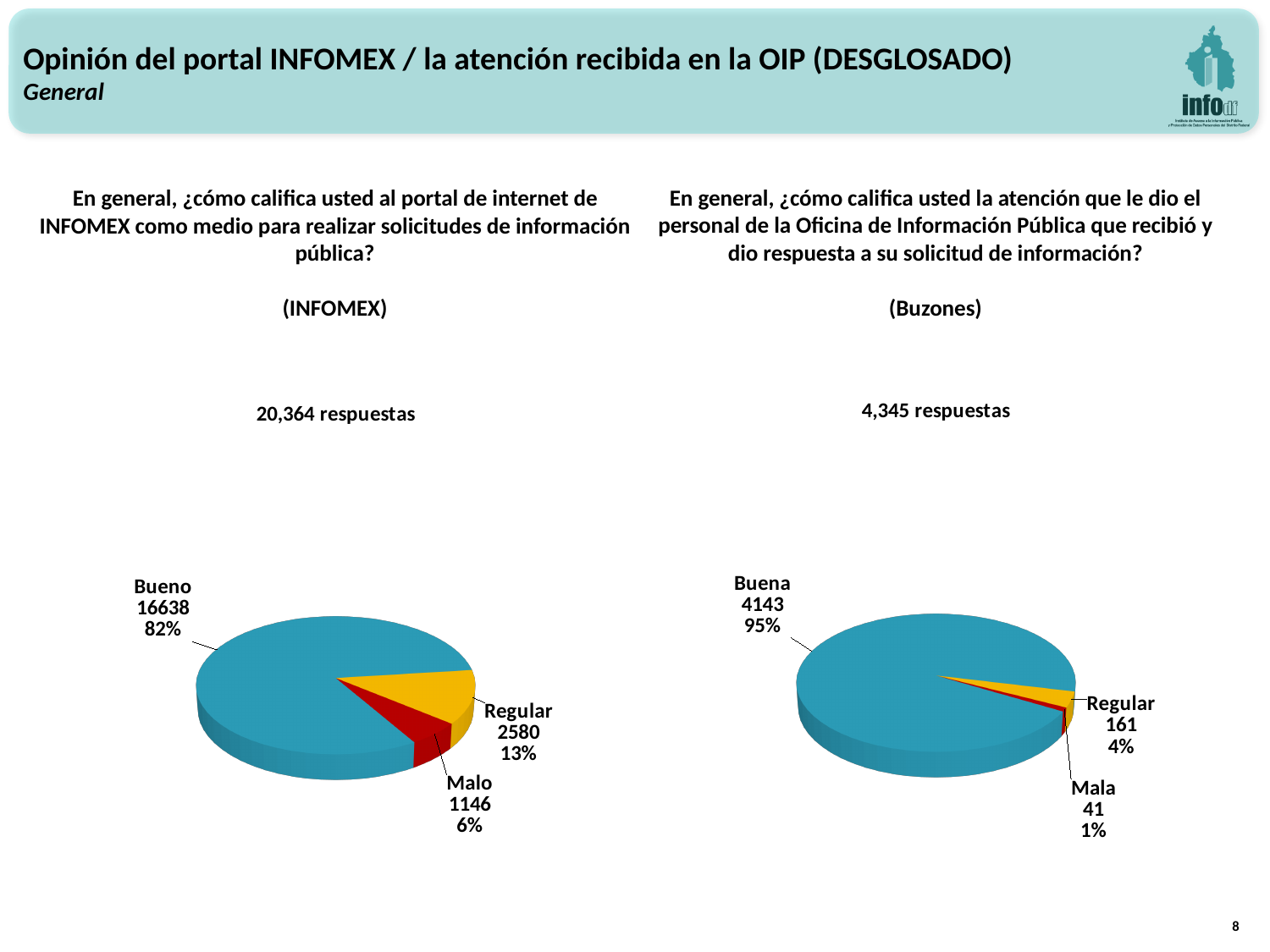
In the Buzones pie chart on the right, how many responses were 'Regular'? 161 In the Buzones pie chart on the right, what percentage of responses were 'Buena'? 95% In the INFOMEX pie chart on the left, what percentage of responses were 'Regular'? 13% How many categories does the INFOMEX pie chart on the left show? 3 In the Buzones pie chart on the right, which category has the largest slice? Buena In the INFOMEX pie chart on the left, how many responses were 'Bueno'? 16638 In the INFOMEX pie chart on the left, which category has the smallest slice? Malo In the Buzones pie chart on the right, which is larger: the number of 'Regular' responses or the number of 'Mala' responses? Regular What type of chart is used on the right for the Buzones data? Pie chart In the Buzones pie chart on the right, how many responses were 'Mala'? 41 In the INFOMEX pie chart on the left, how many responses were 'Malo'? 1146 In the INFOMEX pie chart on the left, what is the difference between the number of 'Regular' and 'Malo' responses? 1434